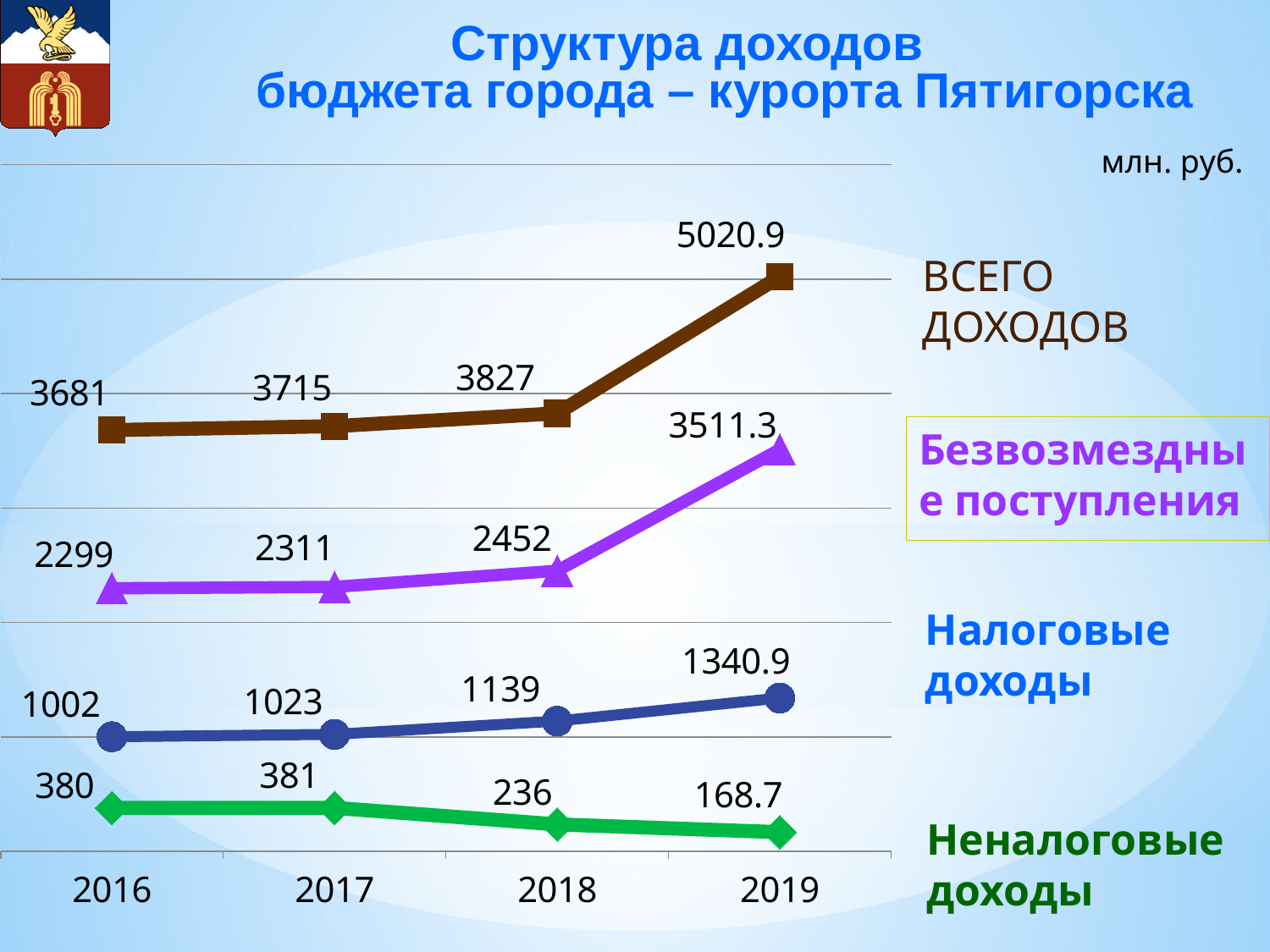
What is the value of ВСЕГО ДОХОДОВ in 2019? 5020.9 Do the values for Неналоговые доходы rise or fall from 2017 to 2019? Fall What is the value of Налоговые доходы in 2017? 1023 How many years are shown on the x axis? 4 How many series are plotted on the chart? 4 What kind of chart is shown on the slide? Line chart Which is larger: Налоговые доходы in 2019 or Неналоговые доходы in 2016? Налоговые доходы in 2019 What is the value of Неналоговые доходы in 2019? 168.7 In which year is Неналоговые доходы lowest? 2019 What is the value of Безвозмездные поступления in 2018? 2452 In which year is ВСЕГО ДОХОДОВ highest? 2019 What is the difference between ВСЕГО ДОХОДОВ in 2019 and in 2018? 1193.9